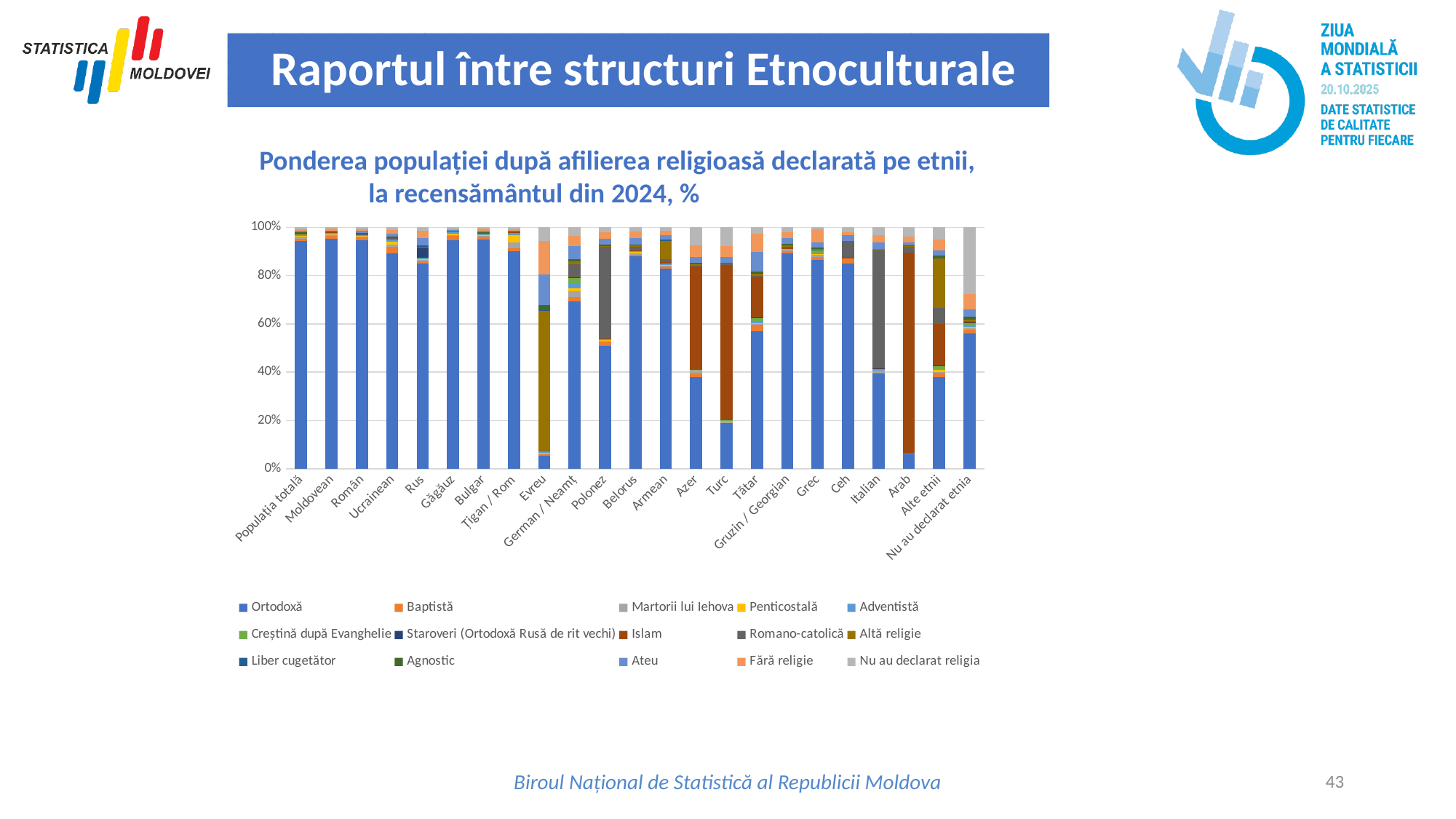
Is the Ortodoxă share for Arab greater or less than 20%? less What kind of chart is shown on the slide? Stacked bar chart Which has a larger Islam share, Arab or Turc? Arab Is the Ortodoxă share for Azer greater or less than 60%? less How many ethnic categories are shown along the x axis of the chart? 23 Is the Ortodoxă share for Polonez greater or less than 40%? greater How many series does the chart legend list? 15 What is the title of the chart? Ponderea populației după afilierea religioasă declarată pe etnii, la recensământul din 2024, % Which has a larger 'Nu au declarat religia' share, 'Nu au declarat etnia' or Moldovean? Nu au declarat etnia Which has a larger Ortodoxă share, Moldovean or Polonez? Moldovean